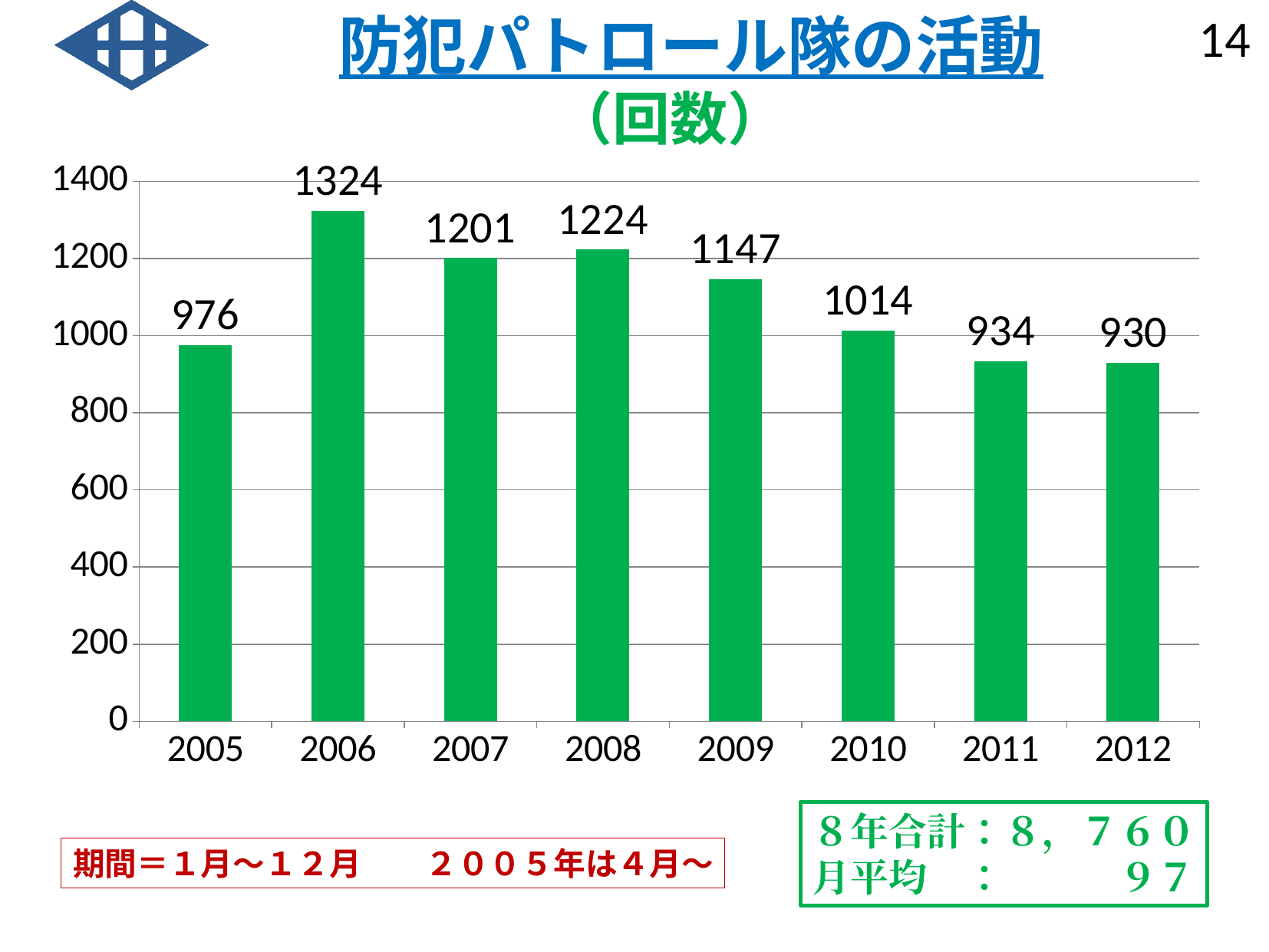
Which year has the lowest value? 2012 What is the difference between the values for 2006 and 2005? 348 Which year has the highest value? 2006 Which is larger, the value for 2008 or the value for 2009? 2008 How many years are shown on the x axis? 8 What is the value for 2006? 1324 What is the difference between the values for 2008 and 2007? 23 What is the value for 2009? 1147 What kind of chart is shown on the slide? bar chart What is the value for 2012? 930 Do the values rise or fall from 2008 to 2012? fall Is the value for 2010 greater or less than 1000? greater